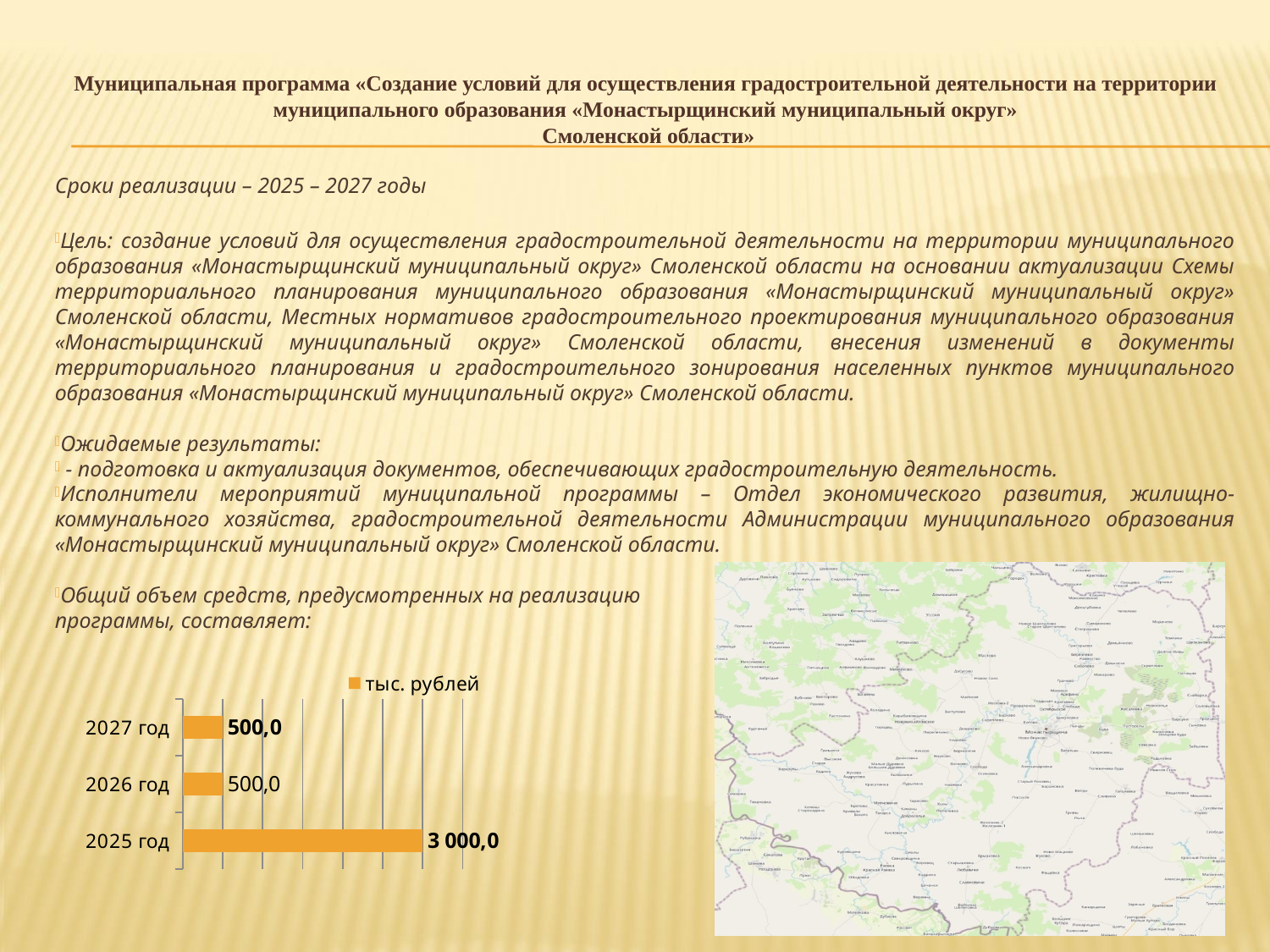
What is the difference between the values for 2025 год and 2026 год? 2 500,0 How many categories (years) are shown in the chart? 3 What is the value for 2025 год in the chart? 3 000,0 How many series does the chart legend list? 1 What colour are the bars in the chart? orange Which year has the highest value in the chart? 2025 год Which is larger, the value for 2025 год or the value for 2027 год? 2025 год What is the total of the values for all three years in the chart? 4 000,0 What is the value for 2027 год in the chart? 500,0 What is the value for 2026 год in the chart? 500,0 What kind of chart is shown on the slide? bar chart What is the legend entry of the chart? тыс. рублей